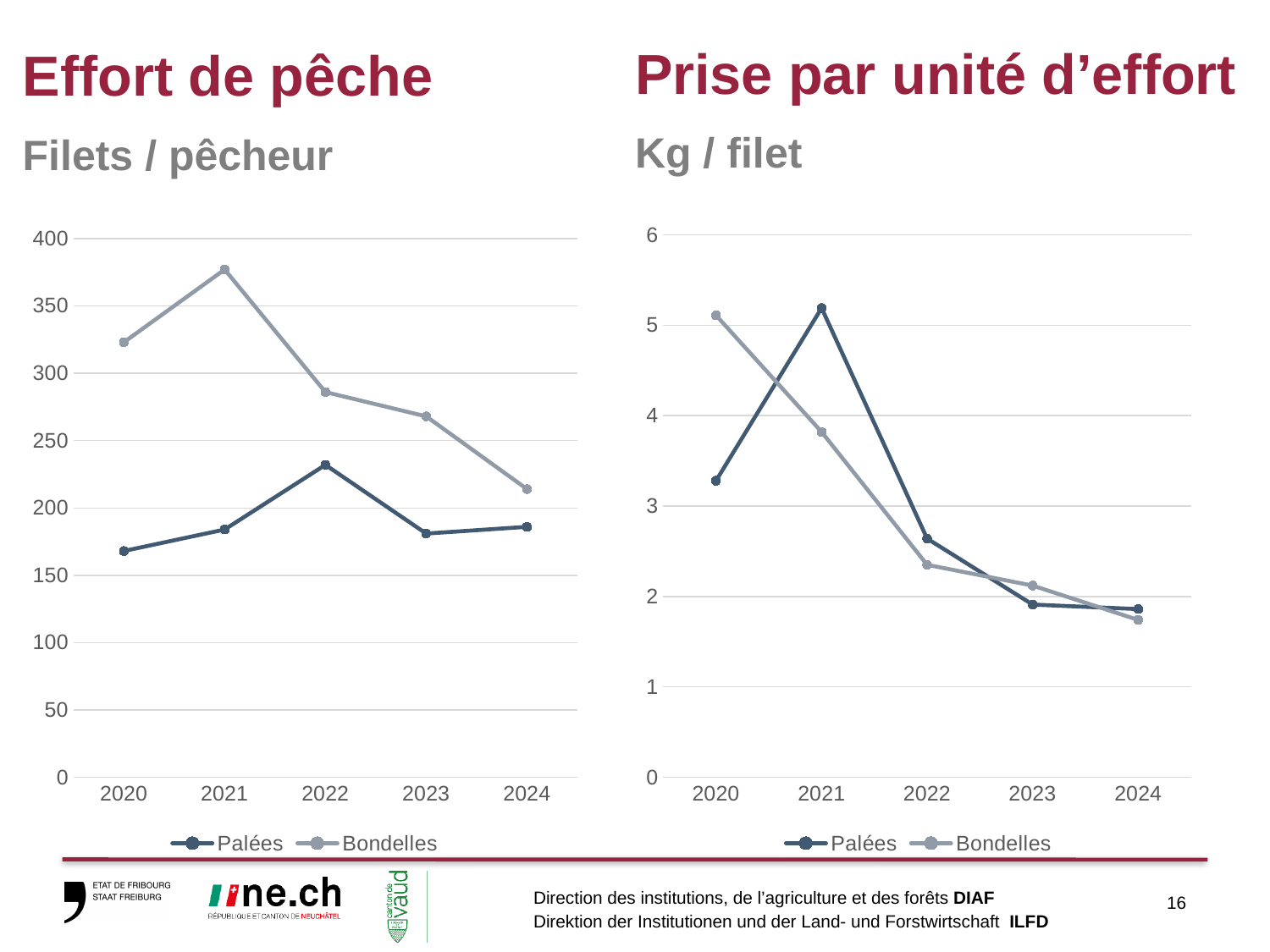
In the 'Effort de pêche' chart, is the Bondelles value for 2021 greater or less than 350? greater In the 'Prise par unité d'effort' chart, is the Palées value for 2020 greater or less than 4? less How many series does the legend of the 'Prise par unité d'effort' chart list? 2 In the 'Effort de pêche' chart, in which year does the Bondelles series reach its highest value? 2021 What kind of chart is the 'Effort de pêche' chart on the left? Line chart In the 'Effort de pêche' chart, in which year does the Palées series reach its highest value? 2022 How many years are plotted on the x axis of the 'Effort de pêche' chart? 5 In the 'Prise par unité d'effort' chart, in which year does the Palées series reach its highest value? 2021 What unit is given in the subtitle of the 'Prise par unité d'effort' chart? Kg / filet In the 'Effort de pêche' chart, does the Bondelles series rise or fall from 2021 to 2024? Fall In the 'Prise par unité d'effort' chart, which series has the higher value in 2020, Palées or Bondelles? Bondelles In the 'Prise par unité d'effort' chart, in which year is the Bondelles series lowest? 2024